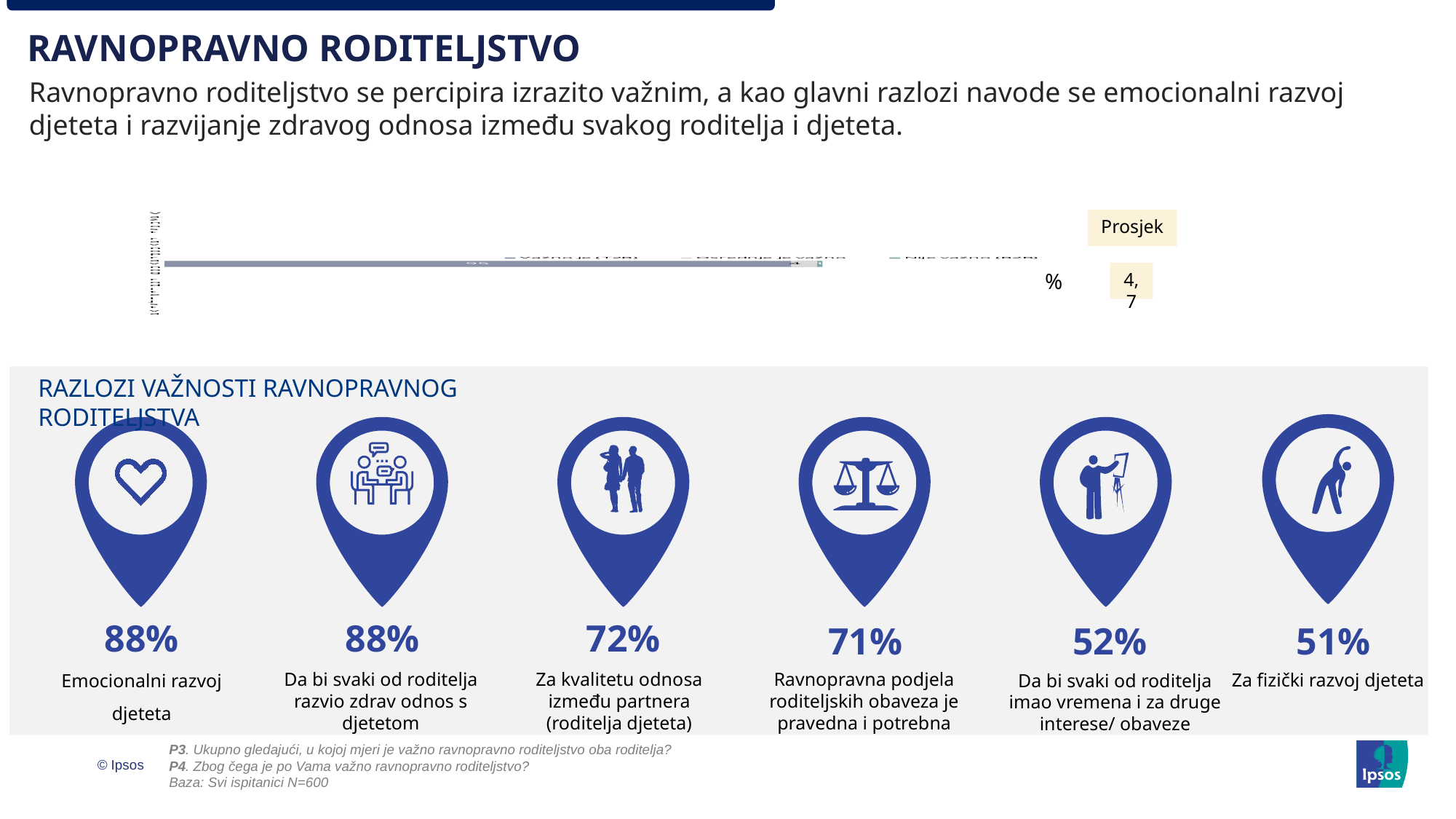
In the 'RAZLOZI VAŽNOSTI RAVNOPRAVNOG RODITELJSTVA' section, what percentage is shown for 'Emocionalni razvoj djeteta'? 88% In the 'RAZLOZI VAŽNOSTI RAVNOPRAVNOG RODITELJSTVA' section, what is the highest percentage shown? 88% In the 'RAZLOZI VAŽNOSTI RAVNOPRAVNOG RODITELJSTVA' section, which reason has the lowest percentage? Za fizički razvoj djeteta In the 'RAZLOZI VAŽNOSTI RAVNOPRAVNOG RODITELJSTVA' section, what is the difference in percentage points between 'Emocionalni razvoj djeteta' and 'Za kvalitetu odnosa između partnera (roditelja djeteta)'? 16 percentage points In the 'RAZLOZI VAŽNOSTI RAVNOPRAVNOG RODITELJSTVA' section, which has a higher percentage: 'Ravnopravna podjela roditeljskih obaveza je pravedna i potrebna' or 'Da bi svaki od roditelja imao vremena i za druge interese/ obaveze'? Ravnopravna podjela roditeljskih obaveza je pravedna i potrebna What 'Prosjek' (average) value is shown next to the top chart? 4,7 How many reasons are shown in the 'RAZLOZI VAŽNOSTI RAVNOPRAVNOG RODITELJSTVA' section? 6 What is the base (Baza) sample size stated at the bottom of the slide? N=600 In the 'RAZLOZI VAŽNOSTI RAVNOPRAVNOG RODITELJSTVA' section, what is the difference in percentage points between 'Ravnopravna podjela roditeljskih obaveza je pravedna i potrebna' and 'Za fizički razvoj djeteta'? 20 percentage points In the 'RAZLOZI VAŽNOSTI RAVNOPRAVNOG RODITELJSTVA' section, what percentage is shown for 'Ravnopravna podjela roditeljskih obaveza je pravedna i potrebna'? 71% In the 'RAZLOZI VAŽNOSTI RAVNOPRAVNOG RODITELJSTVA' section, what percentage is shown for 'Za kvalitetu odnosa između partnera (roditelja djeteta)'? 72% In the 'RAZLOZI VAŽNOSTI RAVNOPRAVNOG RODITELJSTVA' section, what percentage is shown for 'Da bi svaki od roditelja imao vremena i za druge interese/ obaveze'? 52%